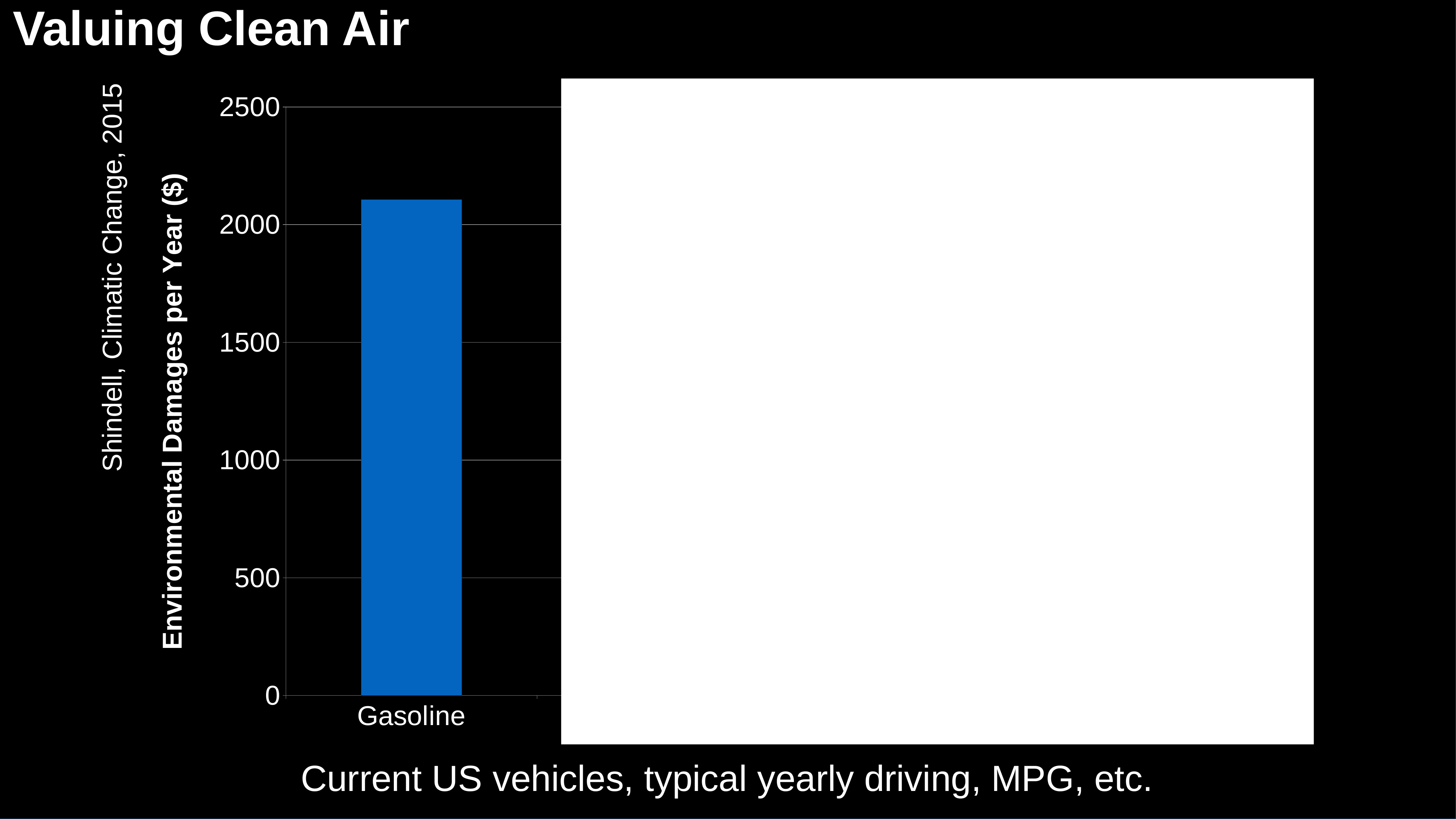
Is the value for Gasoline greater or less than 2000? greater Is the value for Gasoline greater or less than 1500? greater How many bars are visible on the chart? 1 Is the value for Gasoline greater or less than 2500? less What kind of chart is shown on the slide? bar chart What is the label of the visible bar on the chart? Gasoline What is the highest tick value shown on the y-axis? 2500 What is the y-axis label of the chart? Environmental Damages per Year ($)